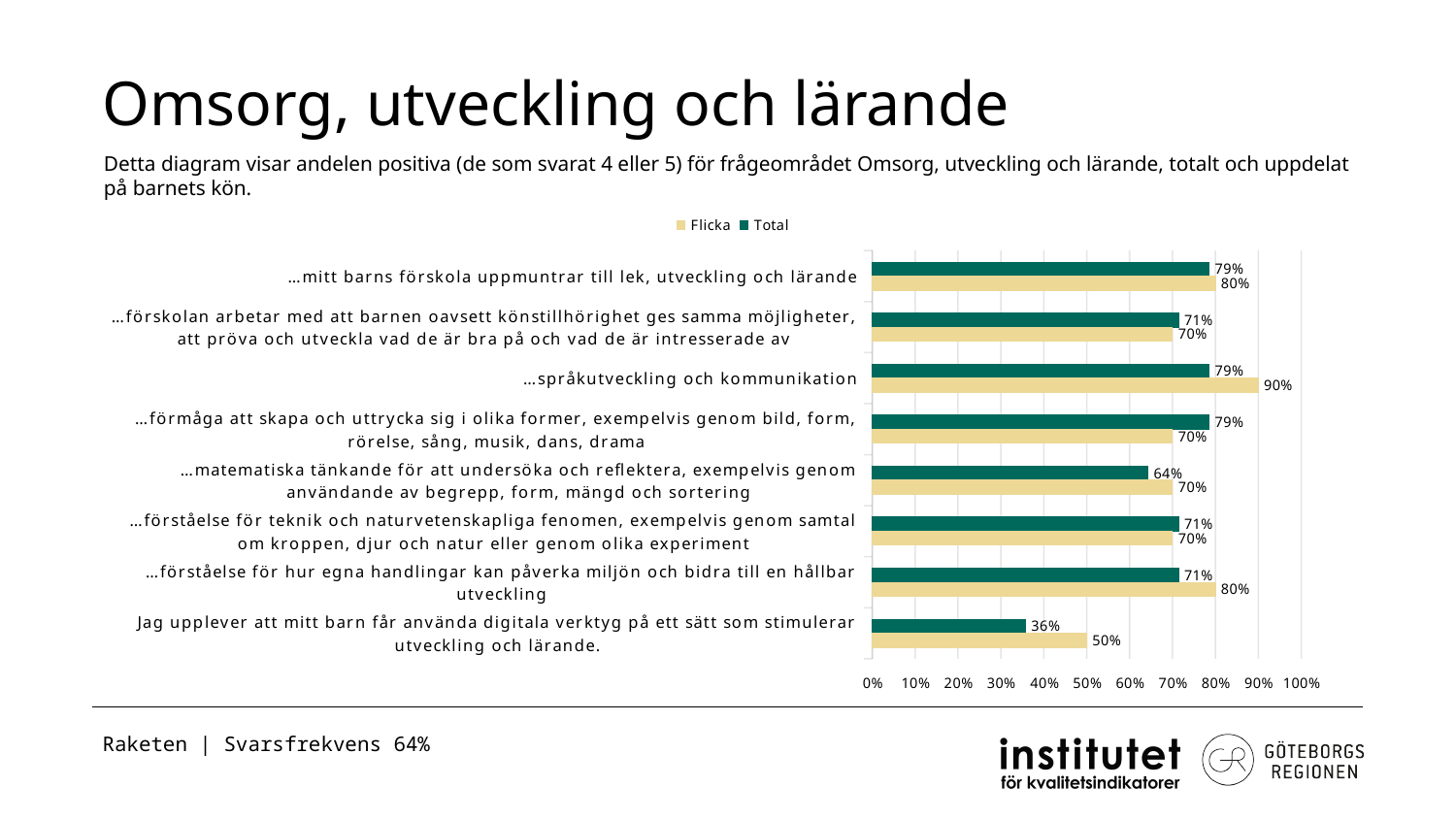
Which category has the highest Flicka value? …språkutveckling och kommunikation How many categories are shown in the chart? 8 How many series does the legend list? 2 What is the difference between the Flicka and Total values for "…språkutveckling och kommunikation"? 11 percentage points What is the Total value for "…språkutveckling och kommunikation"? 79% What is the Flicka value for "…språkutveckling och kommunikation"? 90% Which category has the lowest Total value? Jag upplever att mitt barn får använda digitala verktyg på ett sätt som stimulerar utveckling och lärande. What is the difference between the Flicka and Total values for "Jag upplever att mitt barn får använda digitala verktyg på ett sätt som stimulerar utveckling och lärande."? 14 percentage points What is the Flicka value for "…förståelse för hur egna handlingar kan påverka miljön och bidra till en hållbar utveckling"? 80% What kind of chart is shown on the slide? Bar chart What is the Total value for "Jag upplever att mitt barn får använda digitala verktyg på ett sätt som stimulerar utveckling och lärande."? 36% For "…matematiska tänkande för att undersöka och reflektera, exempelvis genom användande av begrepp, form, mängd och sortering", which is larger, the Flicka value or the Total value? Flicka